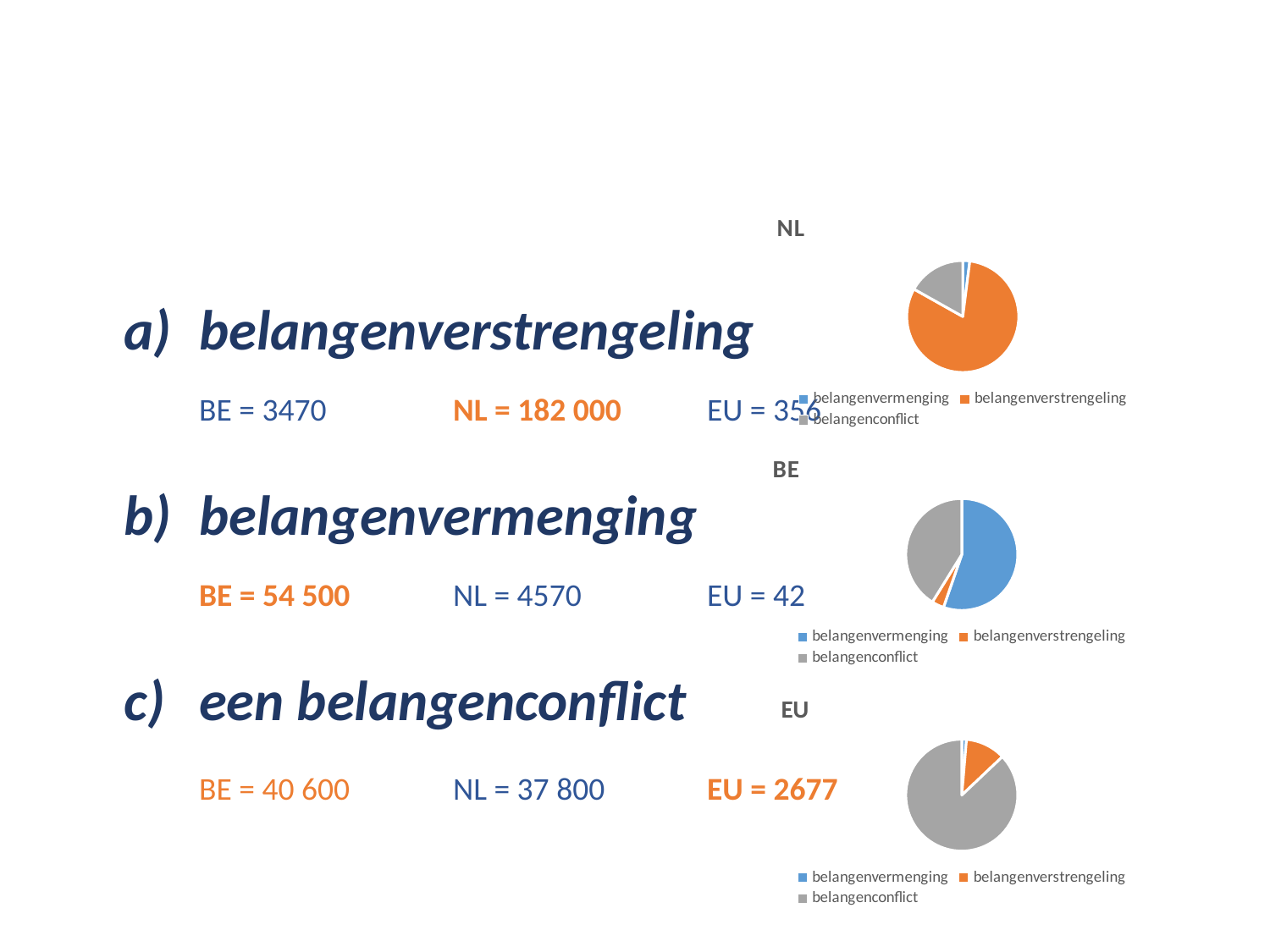
In the NL pie chart, which slice is larger: belangenverstrengeling or belangenconflict? belangenverstrengeling How many charts are shown on the slide? 3 In the NL pie chart, which category has the smallest slice? belangenvermenging In the BE pie chart, which category has the smallest slice? belangenverstrengeling In the EU pie chart, which slice is larger: belangenconflict or belangenverstrengeling? belangenconflict What is the title of the pie chart at the bottom of the slide? EU In the EU pie chart, which category has the largest slice? belangenconflict In the EU pie chart, what colour is the belangenconflict slice? grey What kind of chart is the chart titled NL? pie chart In the EU pie chart, which category has the smallest slice? belangenvermenging In the NL pie chart, which category has the largest slice? belangenverstrengeling How many entries does the legend of the BE pie chart list? 3